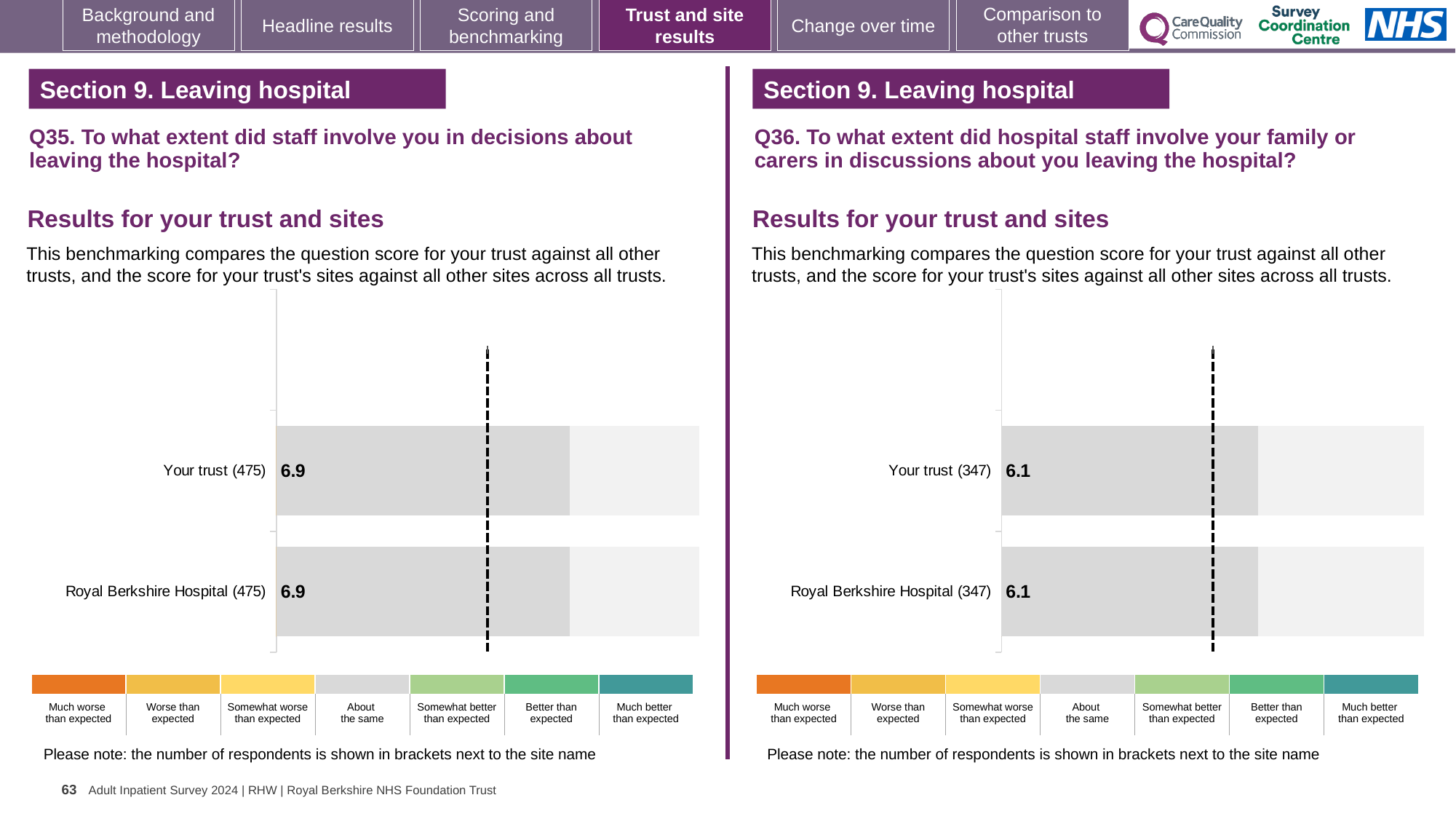
How many bars are plotted in the Q35 chart on the left? 2 What kind of chart is the Q35 chart on the left? Bar chart In the Q35 chart on the left, what is the score for Royal Berkshire Hospital? 6.9 Is the score for Your trust in the Q36 chart on the right larger or smaller than the score for Your trust in the Q35 chart on the left? Smaller In the Q35 chart on the left, what is the score for Your trust? 6.9 In the Q35 chart on the left, how many respondents are shown in brackets next to Your trust? 475 In the Q36 chart on the right, what is the score for Royal Berkshire Hospital? 6.1 In the Q36 chart on the right, what is the score for Your trust? 6.1 How many bars are plotted in the Q36 chart on the right? 2 In the Q35 chart on the left, what is the difference between the score for Your trust and the score for Royal Berkshire Hospital? 0 In the Q36 chart on the right, what is the difference between the score for Your trust and the score for Royal Berkshire Hospital? 0 In the Q36 chart on the right, how many respondents are shown in brackets next to Royal Berkshire Hospital? 347